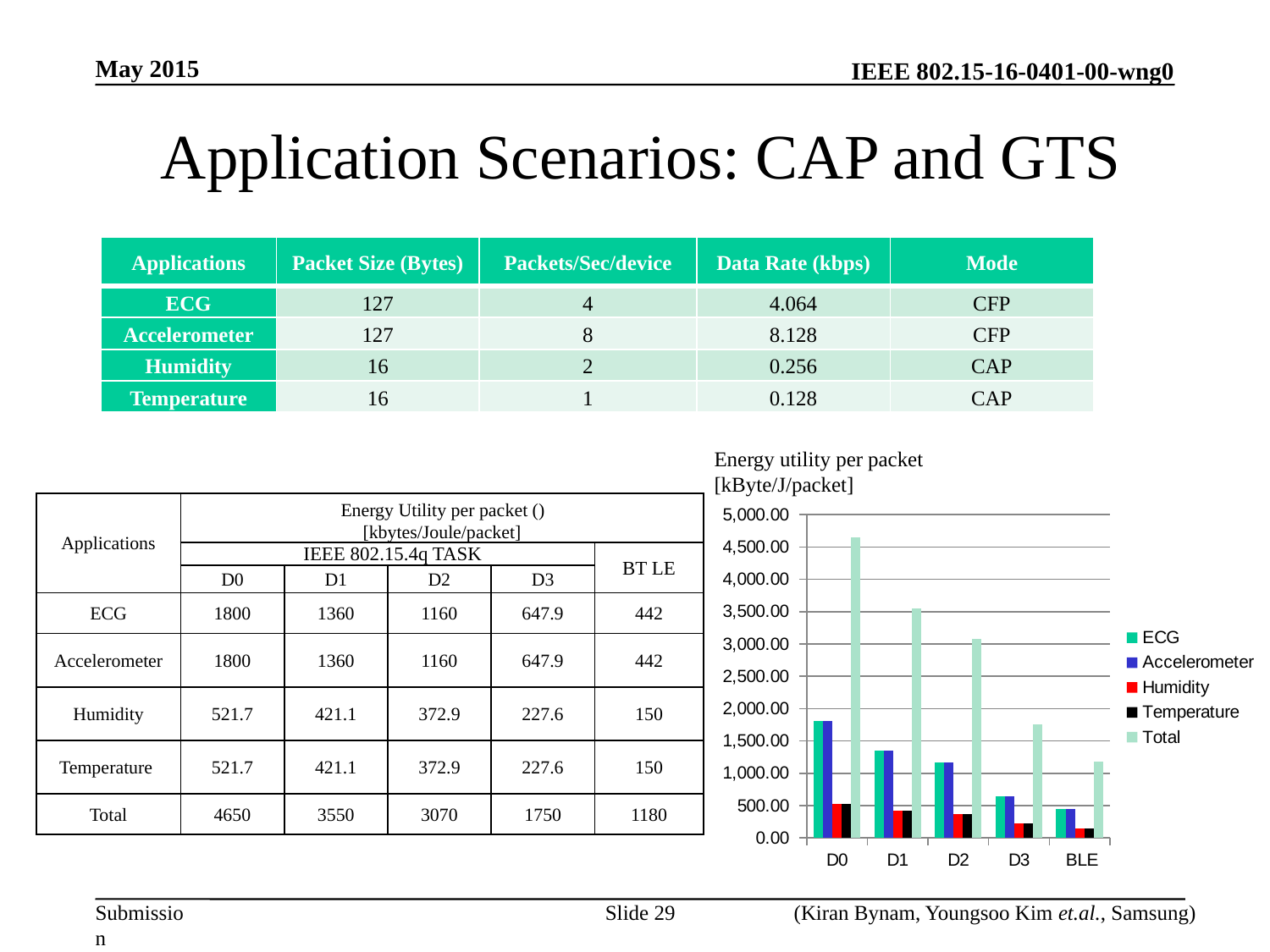
How many series does the chart's legend list? 5 Do the Total bars rise or fall from D0 to D3? fall Is the Total value for D2 greater or less than 3,000.00? greater How many categories are shown along the x axis of the chart? 5 Is the Total value for D3 greater or less than 2,000.00? less Which category has the highest Total bar in the chart? D0 At D0, which is larger: the ECG bar or the Humidity bar? ECG What kind of chart is shown on the slide? bar chart Which category has the lowest Total bar in the chart? BLE What is the title of the chart? Energy utility per packet [kByte/J/packet] Is the Total value for D0 greater or less than 4,500.00? greater